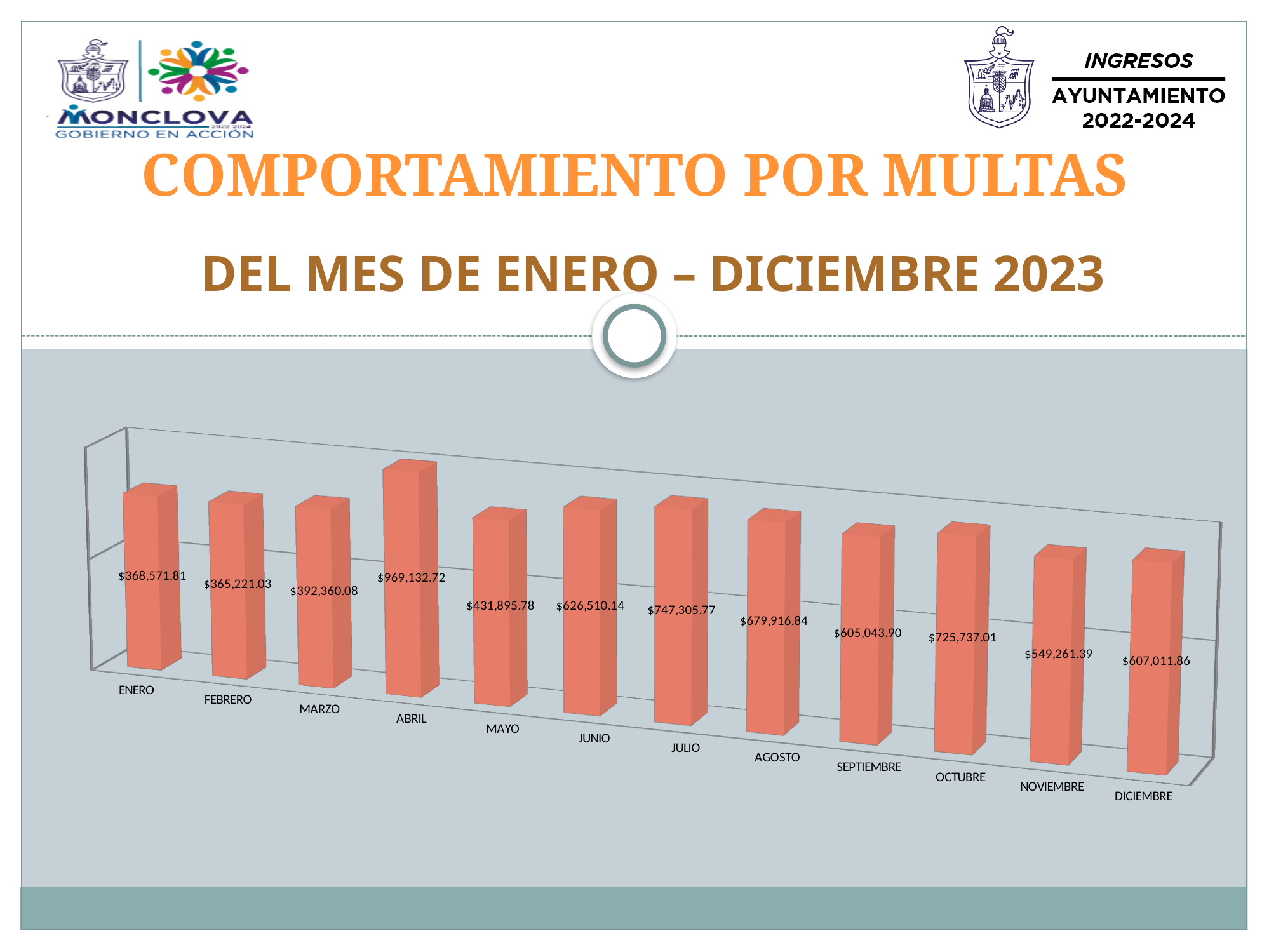
Do the values rise or fall from ENERO to ABRIL? Rise What is the value for ENERO? $368,571.81 What is the difference between the values for ABRIL and ENERO? $600,560.91 What is the value for JULIO? $747,305.77 Which month has the lowest value? FEBRERO What is the value for ABRIL? $969,132.72 Which is larger, the value for JULIO or the value for AGOSTO? JULIO How many months are shown on the chart? 12 What is the value for NOVIEMBRE? $549,261.39 What is the difference between the values for JULIO and JUNIO? $120,795.63 What kind of chart is shown on the slide? Bar chart Which month has the highest value? ABRIL